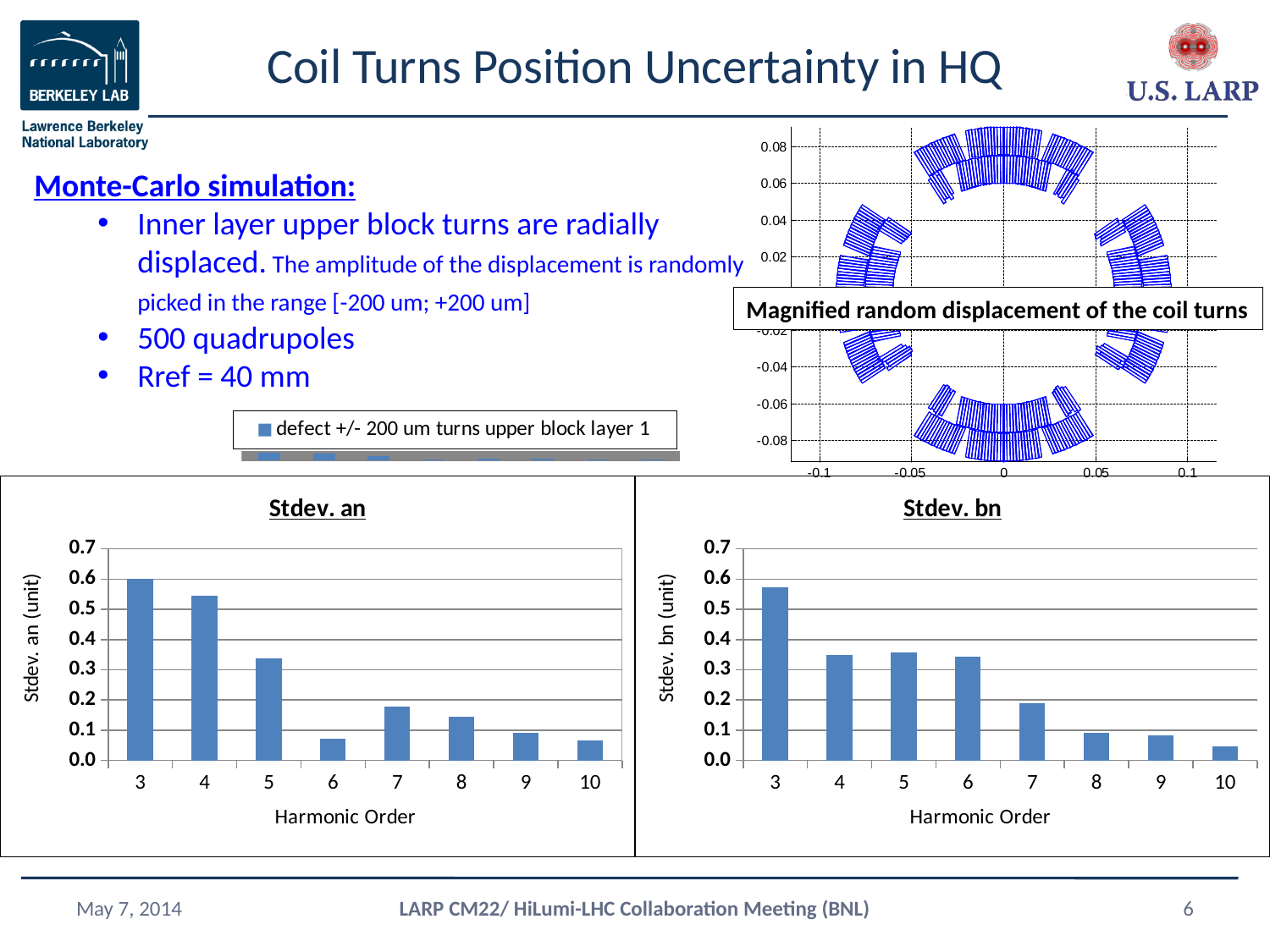
In the Stdev. an chart, is the value for harmonic order 3 greater or less than 0.5? greater In the Stdev. bn chart, is the value for harmonic order 10 greater or less than 0.1? less In the Stdev. an chart, which is larger, the value for harmonic order 4 or harmonic order 5? Harmonic order 4 In the Stdev. bn chart, which harmonic order has the highest standard deviation? 3 In the Stdev. an chart, which harmonic order has the highest standard deviation? 3 What is the x-axis title of the Stdev. an chart? Harmonic Order In the Stdev. bn chart, which harmonic order has the lowest standard deviation? 10 How many harmonic orders are plotted in the Stdev. an chart? 8 In the Stdev. bn chart, is the value for harmonic order 7 greater or less than 0.1? greater In the Stdev. bn chart, which is larger, the value for harmonic order 3 or harmonic order 4? Harmonic order 3 What kind of chart is the Stdev. bn chart? Bar chart